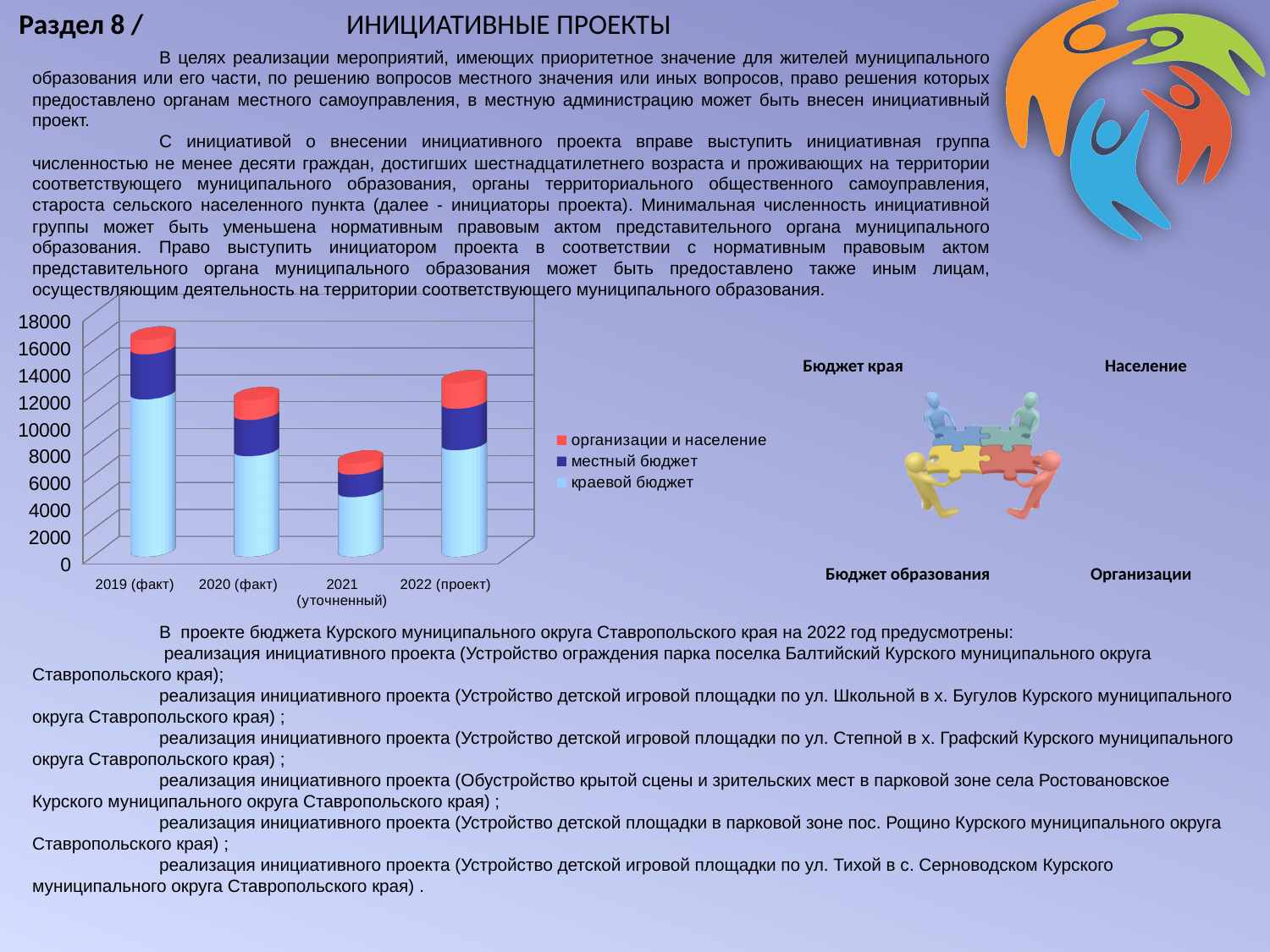
Which stacked bar is taller: 2022 (проект) or 2020 (факт)? 2022 (проект) Which year has the shortest stacked bar in the chart? 2021 (уточненный) What kind of chart is shown on the slide? stacked bar chart Is the total of the stacked bar for 2020 (факт) greater or less than 10000? greater Which year has the tallest stacked bar in the chart? 2019 (факт) Is the total of the stacked bar for 2021 (уточненный) greater or less than 8000? less How many series does the chart legend list? 3 Do the stacked bar totals rise or fall from 2019 (факт) to 2021 (уточненный)? fall How many categories (years) are shown on the x axis of the chart? 4 Which series in the chart legend is shown in red? организации и население Which stacked bar is taller: 2019 (факт) or 2021 (уточненный)? 2019 (факт)